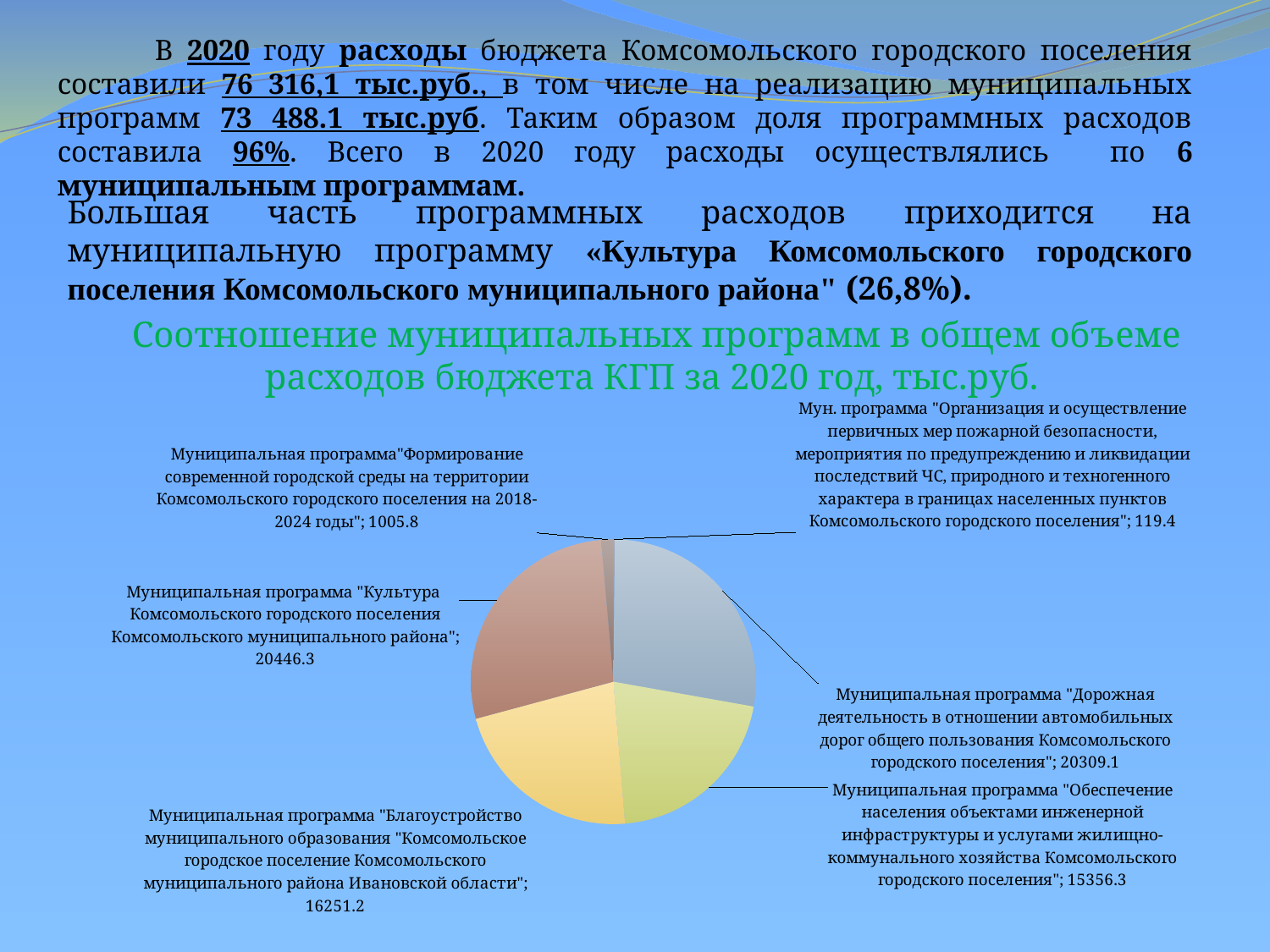
Which is larger: the value for "Формирование современной городской среды..." or for "Организация и осуществление первичных мер пожарной безопасности..."? Формирование современной городской среды (1005.8) Which program has the smallest value in the pie chart? Организация и осуществление первичных мер пожарной безопасности (119.4) What is the value for the program "Культура Комсомольского городского поселения Комсомольского муниципального района"? 20446.3 What is the difference between the values for "Благоустройство..." (16251.2) and "Обеспечение населения объектами инженерной инфраструктуры..." (15356.3)? 894.9 What is the value for the program "Организация и осуществление первичных мер пожарной безопасности..."? 119.4 Which program has the largest value in the pie chart? Культура Комсомольского городского поселения Комсомольского муниципального района (20446.3) What is the value for the program "Формирование современной городской среды на территории Комсомольского городского поселения на 2018-2024 годы"? 1005.8 What kind of chart is shown on the slide? Pie chart How many slices (municipal programs) does the pie chart have? 6 What is the value for the program "Благоустройство муниципального образования "Комсомольское городское поселение Комсомольского муниципального района Ивановской области""? 16251.2 What is the title of the pie chart? Соотношение муниципальных программ в общем объеме расходов бюджета КГП за 2020 год, тыс.руб. What is the value for the program "Дорожная деятельность в отношении автомобильных дорог общего пользования Комсомольского городского поселения"? 20309.1